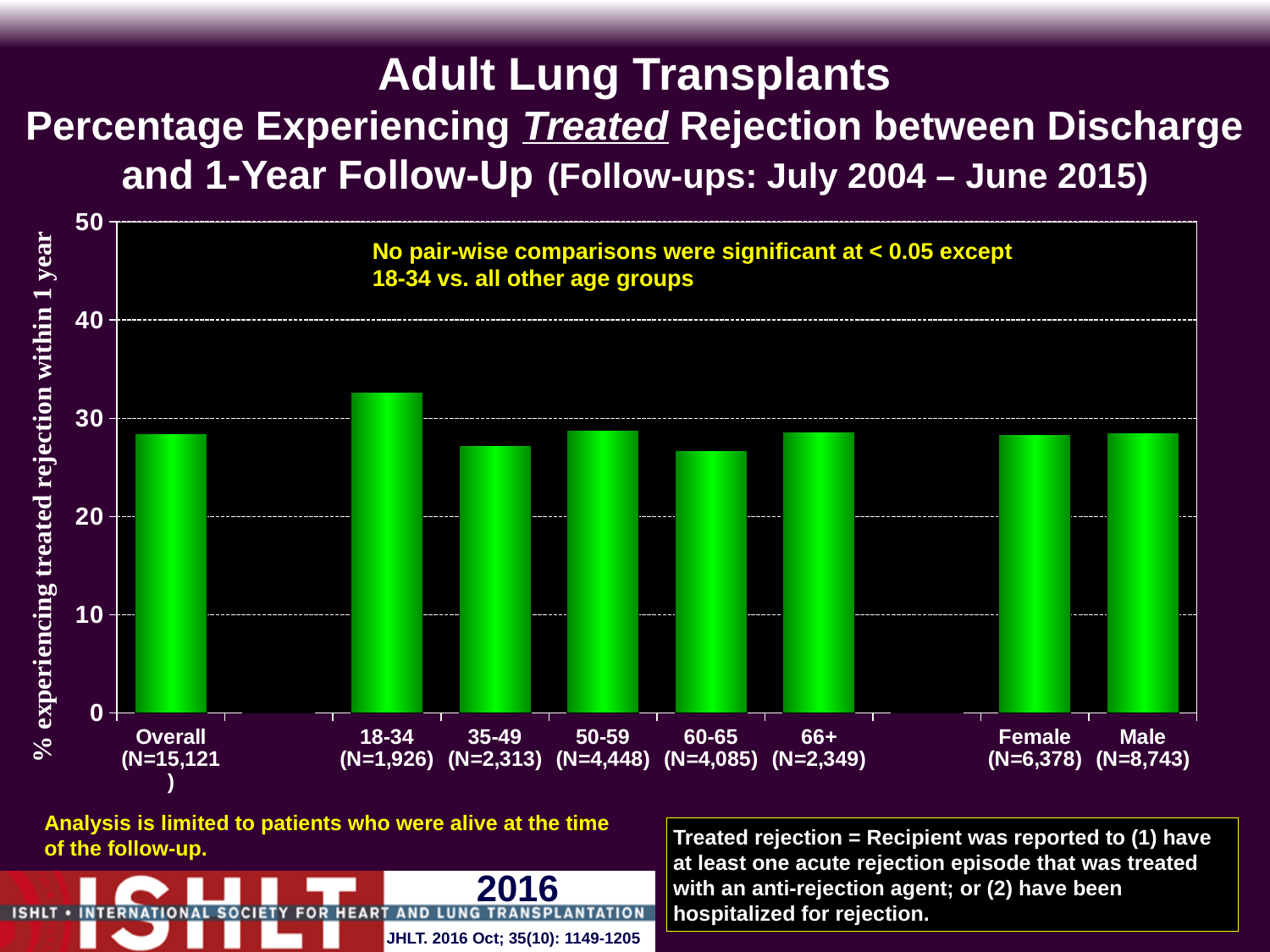
Is the value for the 18-34 age group greater or less than 30? greater What is the N shown for the Overall category? N=15,121 Is the value for Overall greater or less than 30? less Is the value for the 60-65 age group greater or less than 30? less What is the label of the y-axis? % experiencing treated rejection within 1 year What kind of chart is shown on the slide? bar chart Which has a larger value, the 18-34 age group or the 60-65 age group? 18-34 How many bars are plotted in the chart? 8 Which has a larger value, the 18-34 age group or the 35-49 age group? 18-34 Which category has the highest percentage experiencing treated rejection within 1 year? 18-34 How many age-group categories (excluding Overall, Female and Male) are plotted? 5